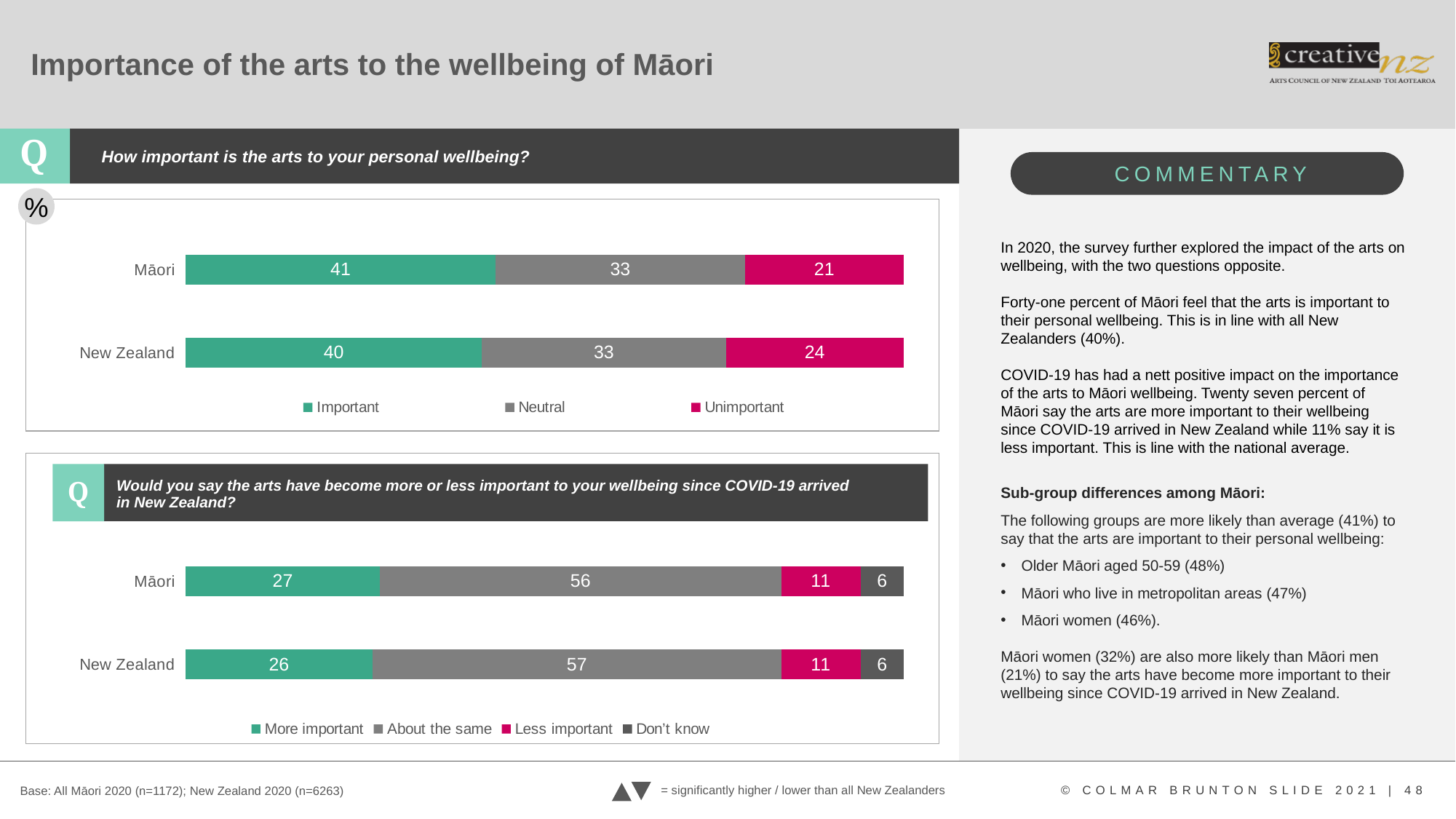
In the bottom chart (Would you say the arts have become more or less important to your wellbeing since COVID-19 arrived in New Zealand?), which segment is largest for Māori? About the same In the bottom chart (Would you say the arts have become more or less important to your wellbeing since COVID-19 arrived in New Zealand?), what is the More important value for New Zealand? 26 In the bottom chart (Would you say the arts have become more or less important to your wellbeing since COVID-19 arrived in New Zealand?), which segment is smallest for New Zealand? Don't know In the top chart (How important is the arts to your personal wellbeing?), how many series does the legend list? 3 In the top chart (How important is the arts to your personal wellbeing?), what percentage of Māori say the arts are Important? 41 In the top chart (How important is the arts to your personal wellbeing?), what is the difference between the Unimportant values for New Zealand and Māori? 3 In the bottom chart (Would you say the arts have become more or less important to your wellbeing since COVID-19 arrived in New Zealand?), what is the About the same value for Māori? 56 In the bottom chart (Would you say the arts have become more or less important to your wellbeing since COVID-19 arrived in New Zealand?), how many series does the legend list? 4 What type of chart is the top chart (How important is the arts to your personal wellbeing?)? Stacked bar chart In the top chart (How important is the arts to your personal wellbeing?), what is the total of the Māori stacked bar? 95 In the bottom chart (Would you say the arts have become more or less important to your wellbeing since COVID-19 arrived in New Zealand?), what is the total of the New Zealand stacked bar? 100 In the top chart (How important is the arts to your personal wellbeing?), what is the Unimportant value for New Zealand? 24